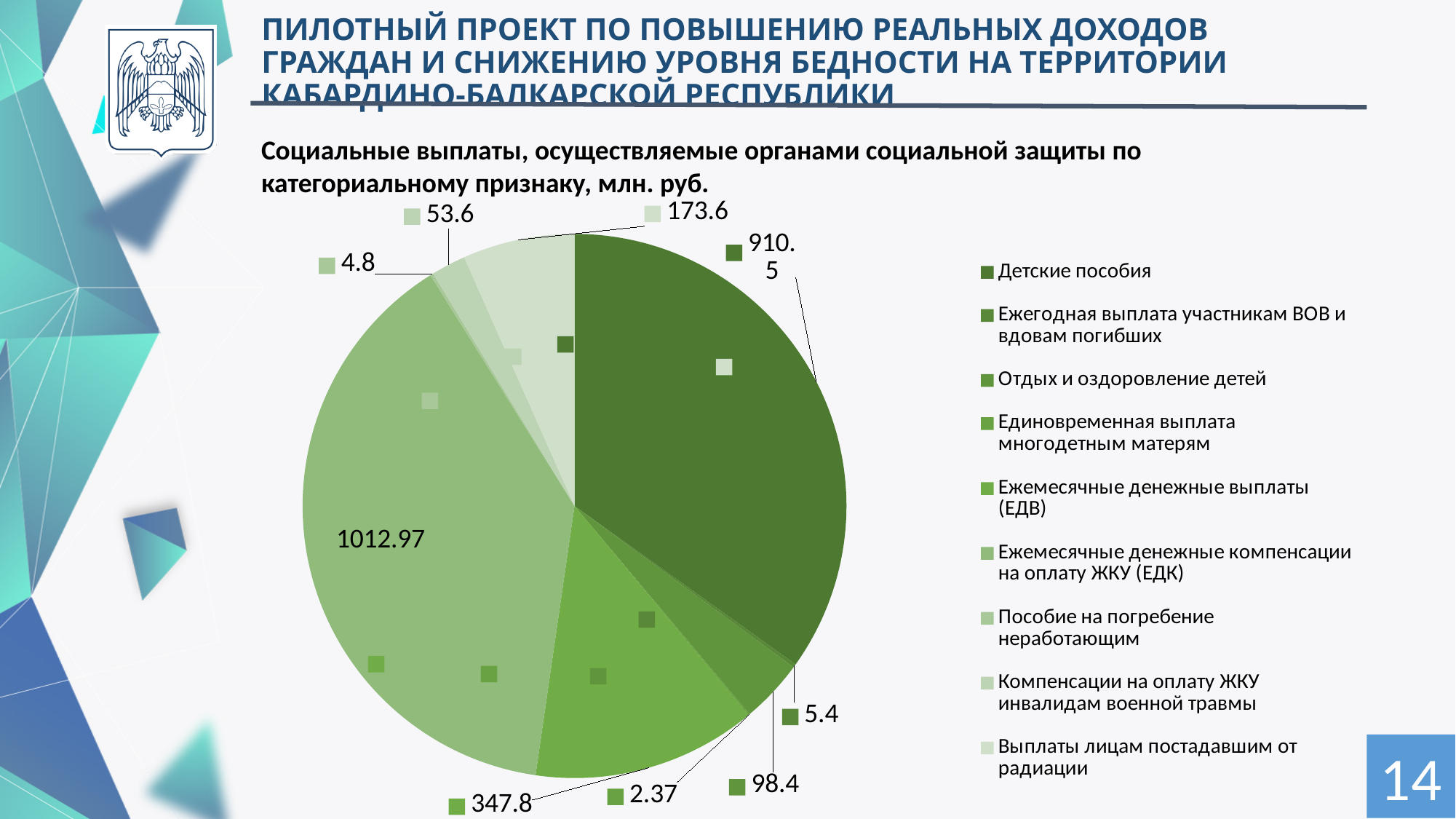
What is the difference between the values for Ежемесячные денежные компенсации на оплату ЖКУ (ЕДК) and Детские пособия? 102.47 Which category has the smallest value? Единовременная выплата многодетным матерям Which is larger: Отдых и оздоровление детей or Компенсации на оплату ЖКУ инвалидам военной травмы? Отдых и оздоровление детей How many categories does the legend of the pie chart list? 9 What type of chart is shown on the slide? pie chart In what unit are the values of the pie chart expressed, according to the chart title? млн. руб. What is the value for Выплаты лицам постадавшим от радиации? 173.6 What is the value for Единовременная выплата многодетным матерям? 2.37 What is the value for Ежемесячные денежные выплаты (ЕДВ)? 347.8 What is the value for Ежемесячные денежные компенсации на оплату ЖКУ (ЕДК)? 1012.97 Which category has the largest slice of the pie? Ежемесячные денежные компенсации на оплату ЖКУ (ЕДК) What is the value for Детские пособия? 910.5